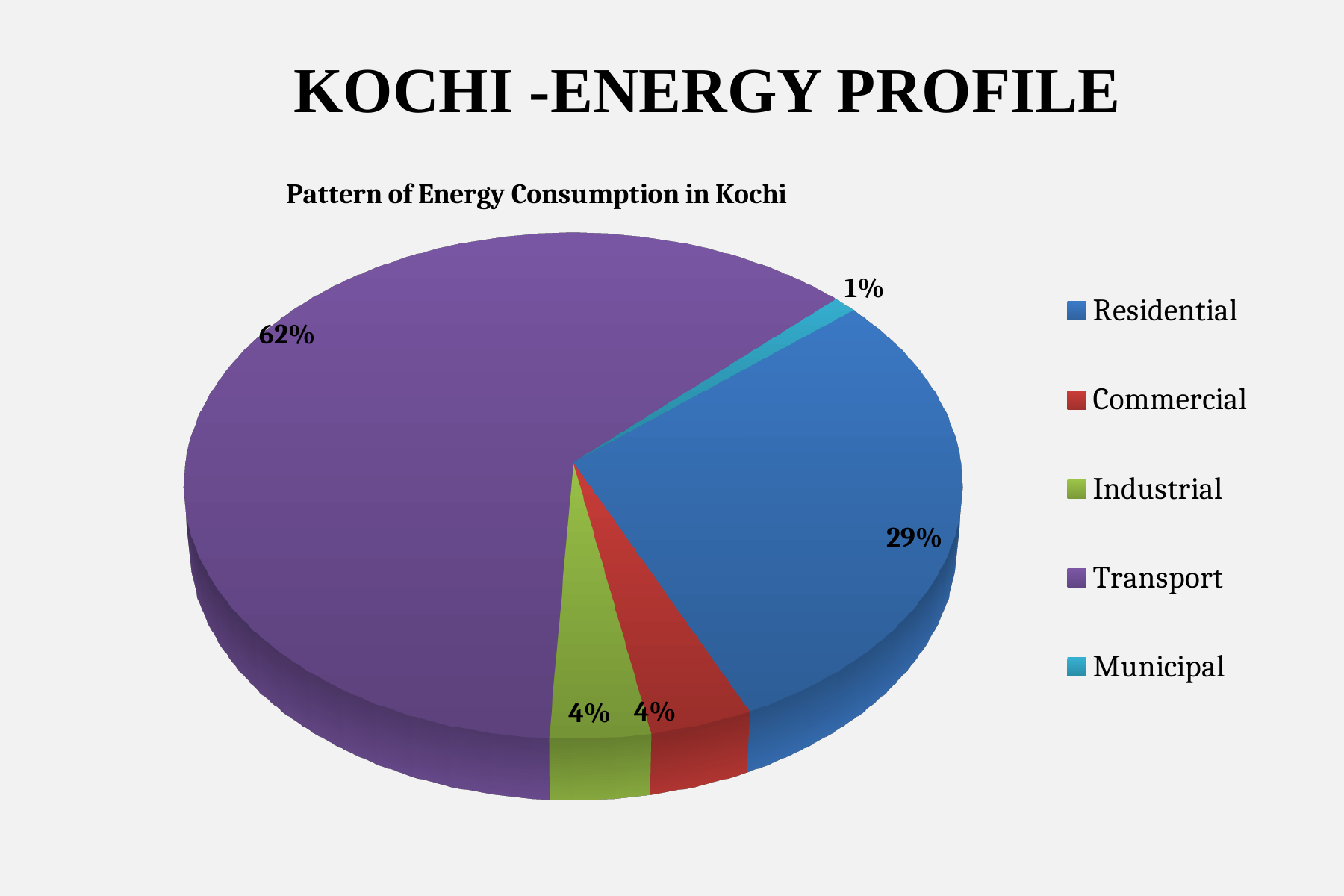
What share of energy consumption does Transport account for? 62% What share of energy consumption does Residential account for? 29% Which is larger, the Residential share or the Commercial share? Residential What is the value shown for Industrial? 4% What is the title of the chart? Pattern of Energy Consumption in Kochi What is the difference between the Transport and Residential shares? 33% What kind of chart is shown on the slide? Pie chart How many sectors are shown in the pie chart? 5 What is the value shown for Municipal? 1% What is the value shown for Commercial? 4% Which sector has the largest share of energy consumption? Transport Which sector has the smallest share of energy consumption? Municipal